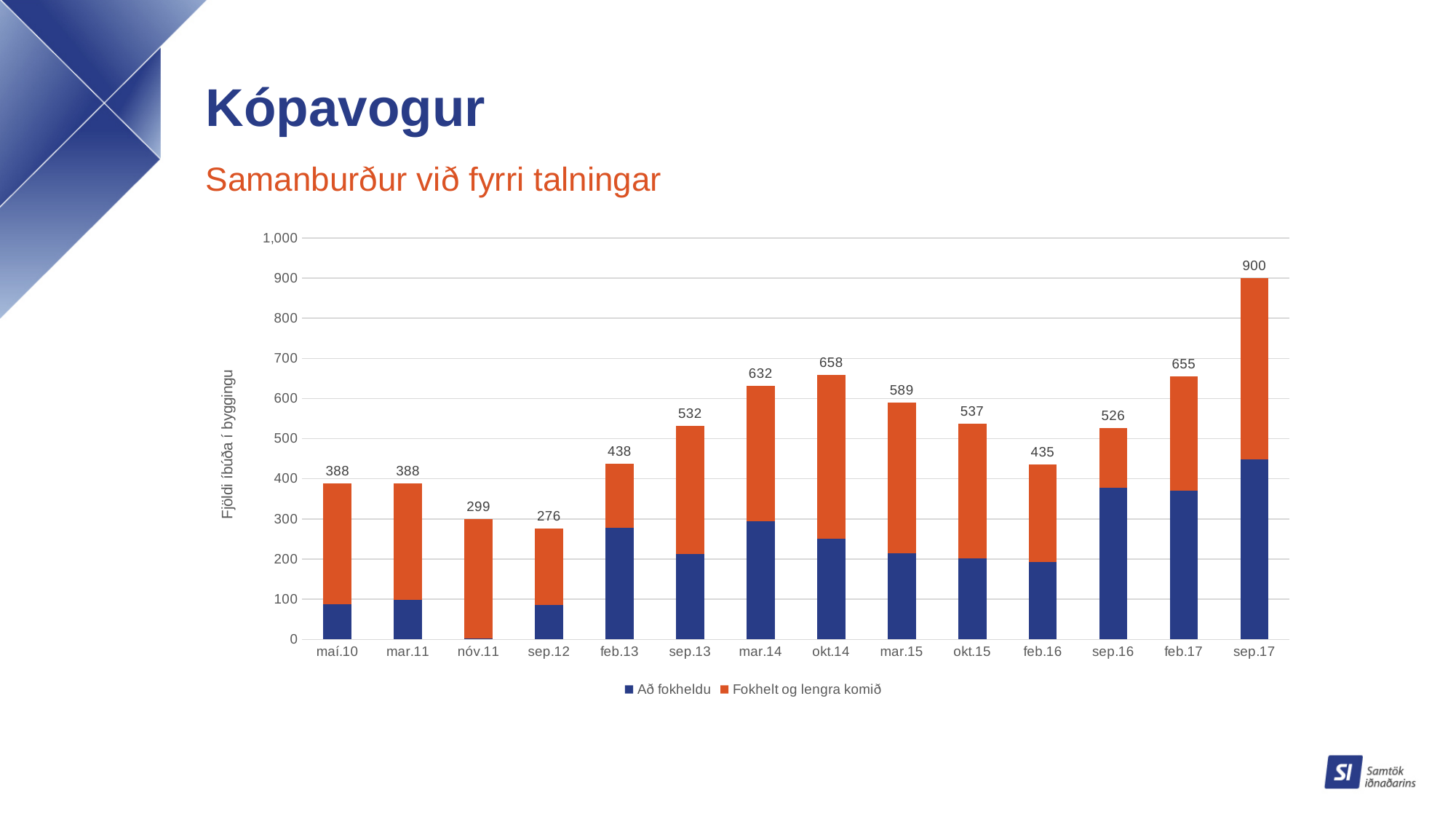
What is the total number of apartments shown for sep.17? 900 What kind of chart is shown on the slide? Stacked bar chart What is the difference between the totals for sep.17 and feb.17? 245 Is the 'Að fokheldu' value for sep.17 greater or less than 400? greater What is the label of the y axis? Fjöldi íbúða í byggingu Which total is larger, okt.14 or mar.15? okt.14 What is the total value shown for nóv.11? 299 Which period has the highest total? sep.17 Is the 'Að fokheldu' value for nóv.11 greater or less than 100? less How many periods are shown on the x axis? 14 How many series does the legend list? 2 Which period has the lowest total? sep.12